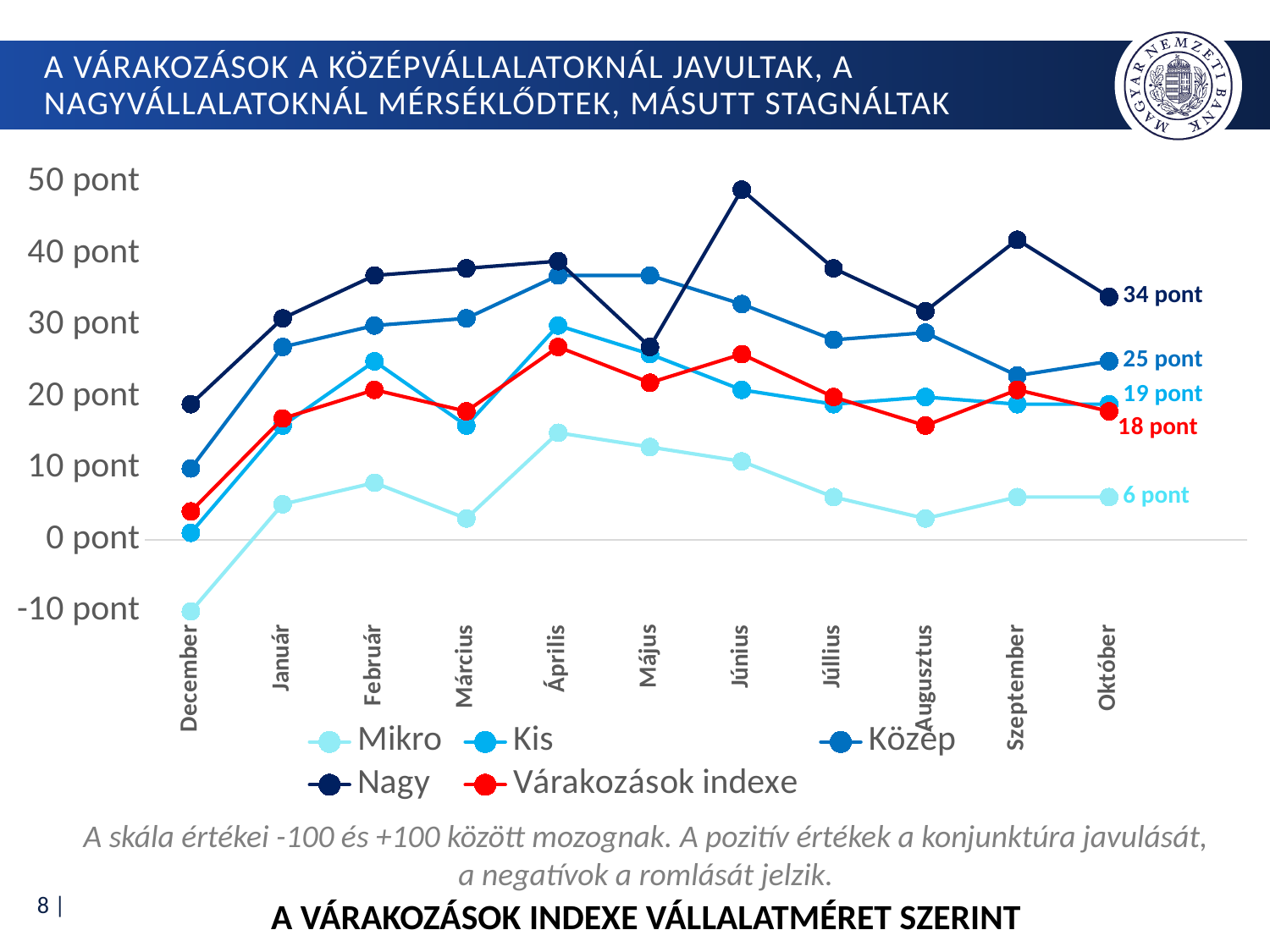
What is the value for Nagy in Október? 34 pont What is the value for Várakozások indexe in Október? 18 pont What is the difference between the Nagy and Mikro values in Október? 28 pont In which month does the Nagy series reach its highest value? Június Is the value for Mikro in December greater or less than 0 pont? less What is the value for Mikro in Október? 6 pont What is the value for Közép in Október? 25 pont How many months are shown on the x axis? 11 How many series does the legend list? 5 What kind of chart is shown on the slide? line chart Is the value for Nagy in Június greater or less than 40 pont? greater Which series has the highest value in Október? Nagy